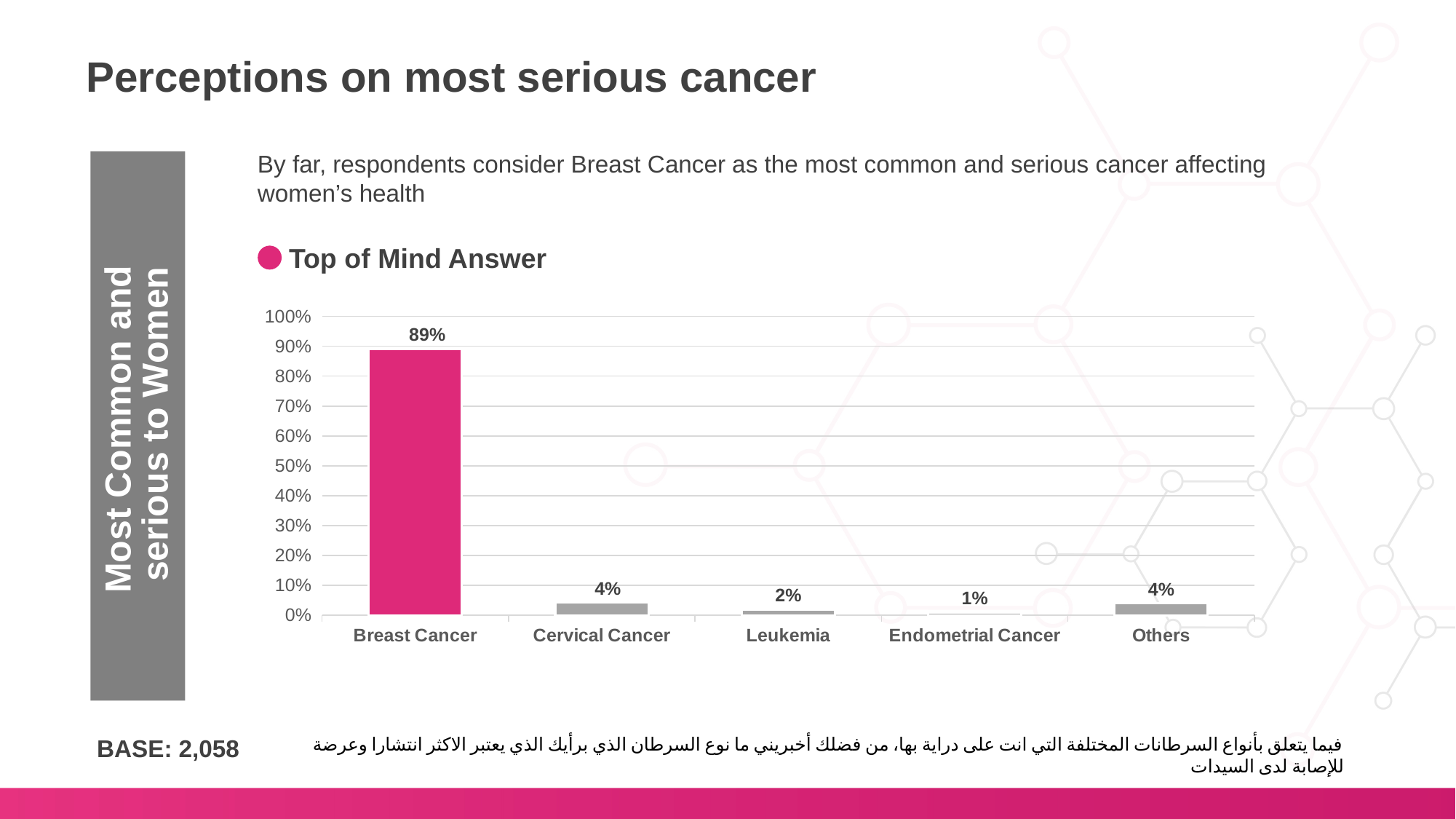
What is the difference between the values for Breast Cancer and Cervical Cancer? 85% How many categories are shown on the x axis of the chart? 5 Which category has the lowest value in the chart? Endometrial Cancer Is the value for Breast Cancer greater or less than 80%? greater What type of chart is shown on the slide? Bar chart Which category has the highest value in the chart? Breast Cancer What is the value shown for Leukemia? 2% What is the label shown next to the pink dot above the chart? Top of Mind Answer What is the value shown for Endometrial Cancer? 1% Which is larger, the value for Leukemia or the value for Others? Others What percentage of respondents named Breast Cancer as the most common and serious cancer? 89% What is the value shown for Cervical Cancer? 4%